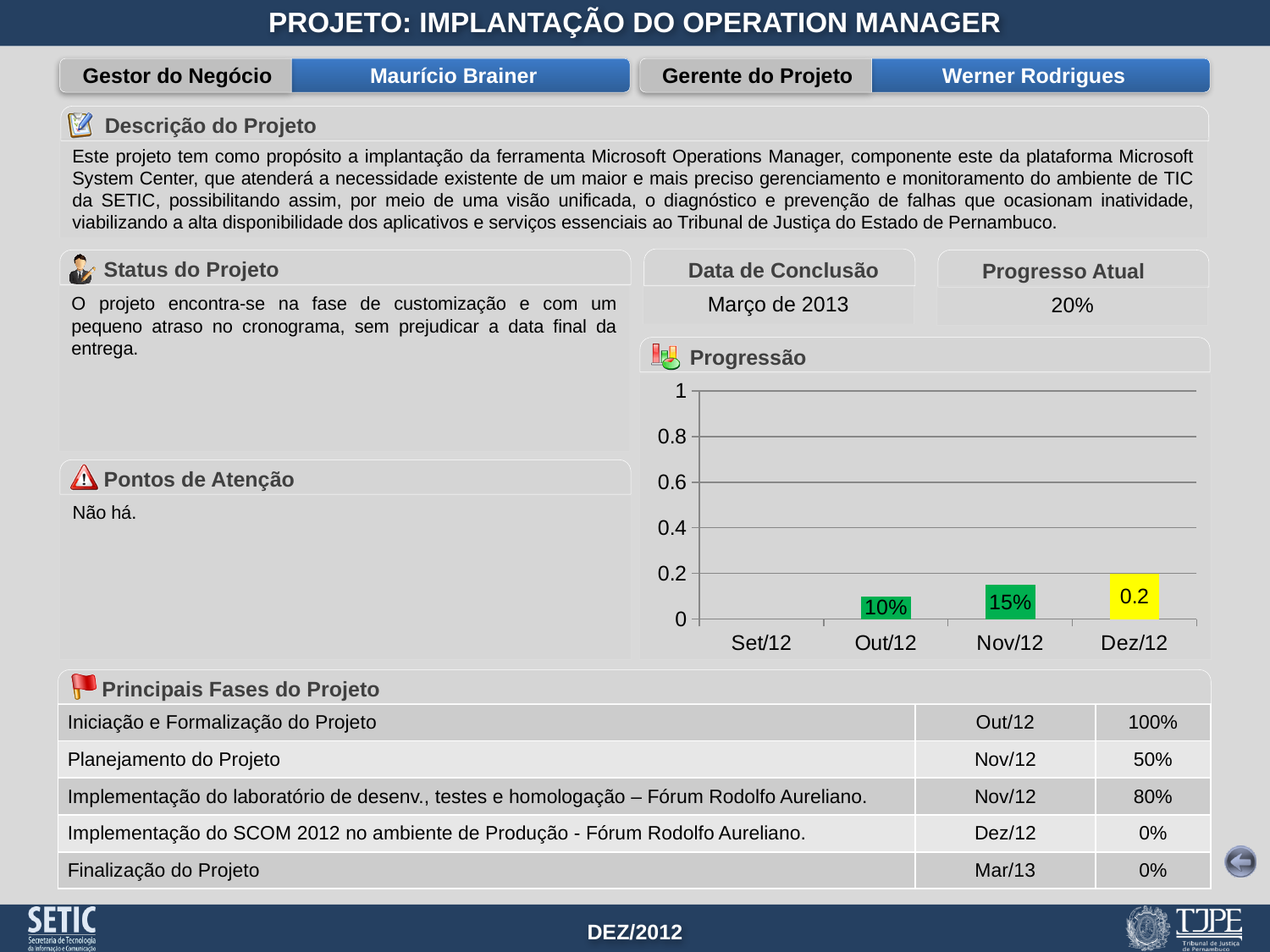
In the Progressão chart, what is the value for Out/12? 10% In the Progressão chart, what colour is the Dez/12 bar? yellow How many months are shown on the x axis of the Progressão chart? 4 In the Progressão chart, which is larger, the value for Nov/12 or the value for Out/12? Nov/12 In the Progressão chart, what is the value labelled on the Dez/12 bar? 0.2 In the Progressão chart, what is the value for Nov/12? 15% In the Progressão chart, what is the difference between the Nov/12 value and the Out/12 value? 5% In the Progressão chart, is the value for Dez/12 greater or less than 0.4? less What kind of chart is the Progressão chart? bar chart In the Progressão chart, do the values rise or fall from Out/12 to Dez/12? rise In the Progressão chart, which month has the highest bar? Dez/12 What is the title of the chart on the slide? Progressão